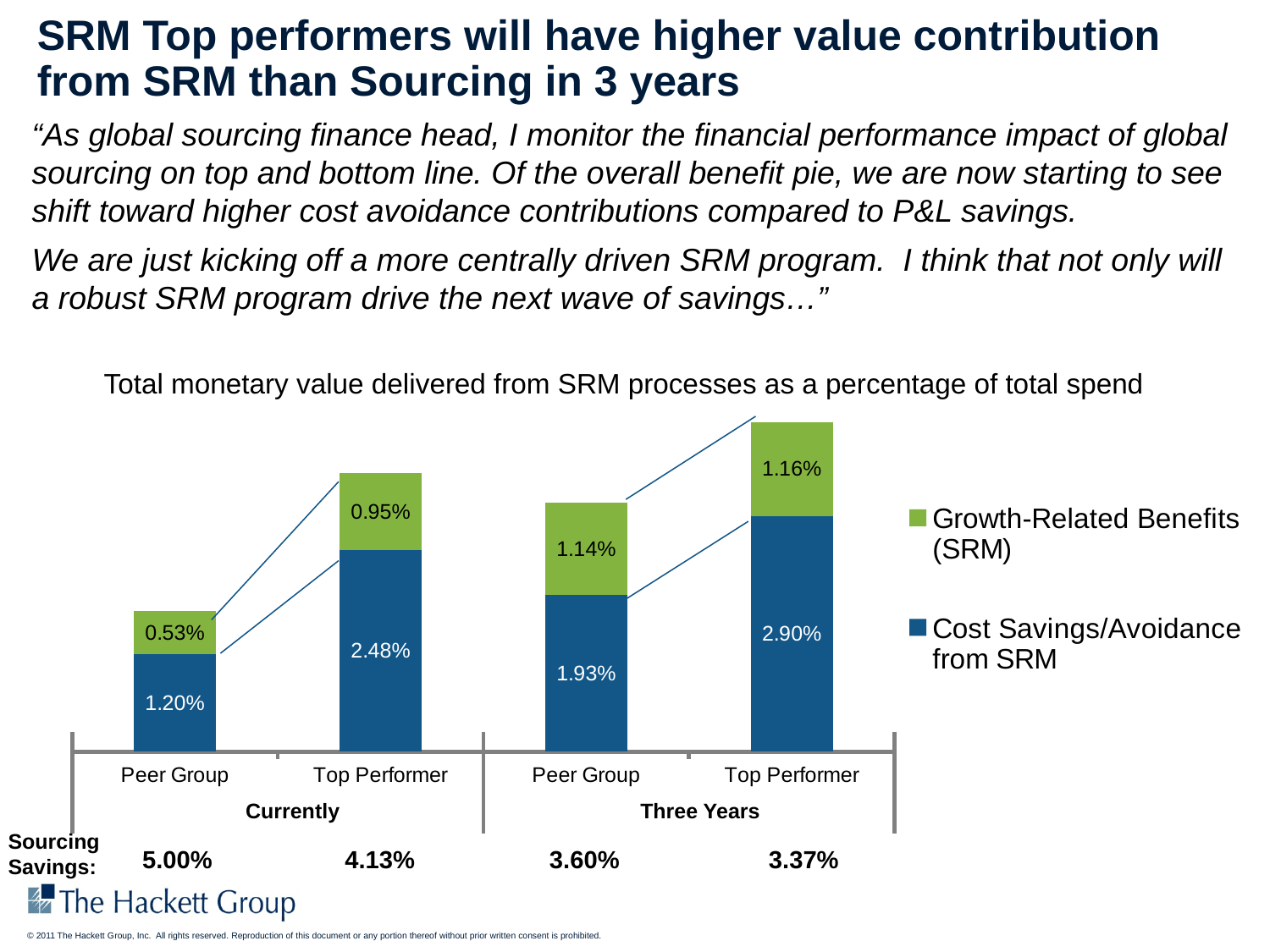
How many series does the legend list? 2 What is the Growth-Related Benefits (SRM) value for the Top Performer bar in the Three Years group? 1.16% What is the Cost Savings/Avoidance from SRM value for the Top Performer bar in the Currently group? 2.48% Which bar has the lowest Growth-Related Benefits (SRM) value? Peer Group (Currently) Which bar has the highest Cost Savings/Avoidance from SRM value? Top Performer (Three Years) Is the Growth-Related Benefits (SRM) value larger for the Peer Group in the Currently group or the Peer Group in the Three Years group? Peer Group in the Three Years group What is the Growth-Related Benefits (SRM) value for the Peer Group bar in the Three Years group? 1.14% What is the total of the Top Performer bar in the Three Years group? 4.06% What is the total of the Peer Group bar in the Currently group? 1.73% What kind of chart is shown on the slide? Stacked bar chart What is the difference between the Cost Savings/Avoidance from SRM values for Top Performer and Peer Group in the Currently group? 1.28% What is the Cost Savings/Avoidance from SRM value for the Peer Group bar in the Currently group? 1.20%